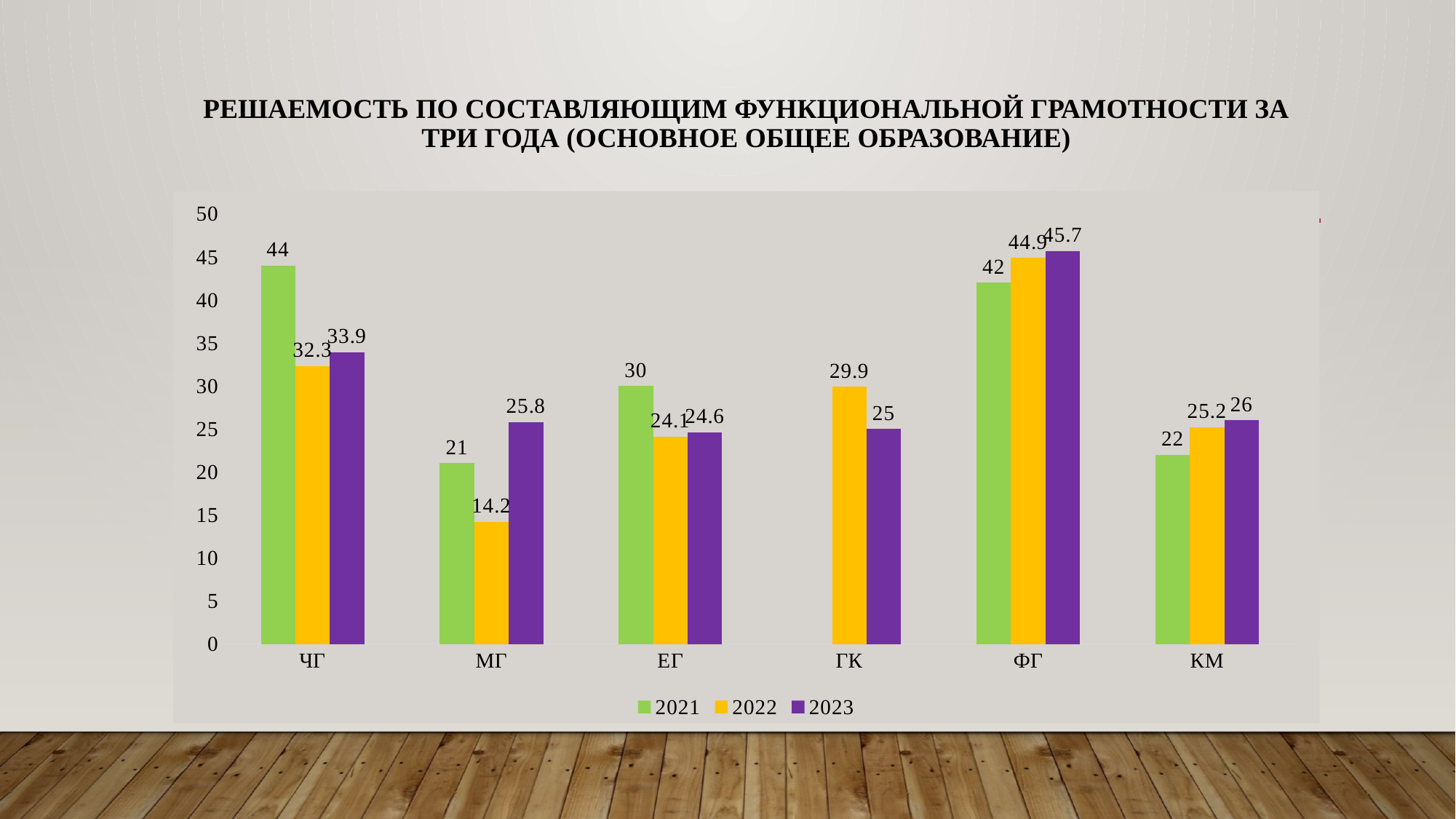
Which colour represents the 2022 series in the legend? yellow What type of chart is shown on the slide? bar chart What is the value for ЧГ in 2021? 44 Which category has the highest value in 2023? ФГ How many categories are shown on the x axis? 6 Do the values for КМ rise or fall from 2021 to 2023? rise What is the difference between the 2023 and 2022 values for МГ? 11.6 What is the value for МГ in 2022? 14.2 Which is larger for ГК: the 2022 value or the 2023 value? 2022 What is the value for ФГ in 2023? 45.7 Which category has the lowest value in 2022? МГ How many series does the legend list? 3